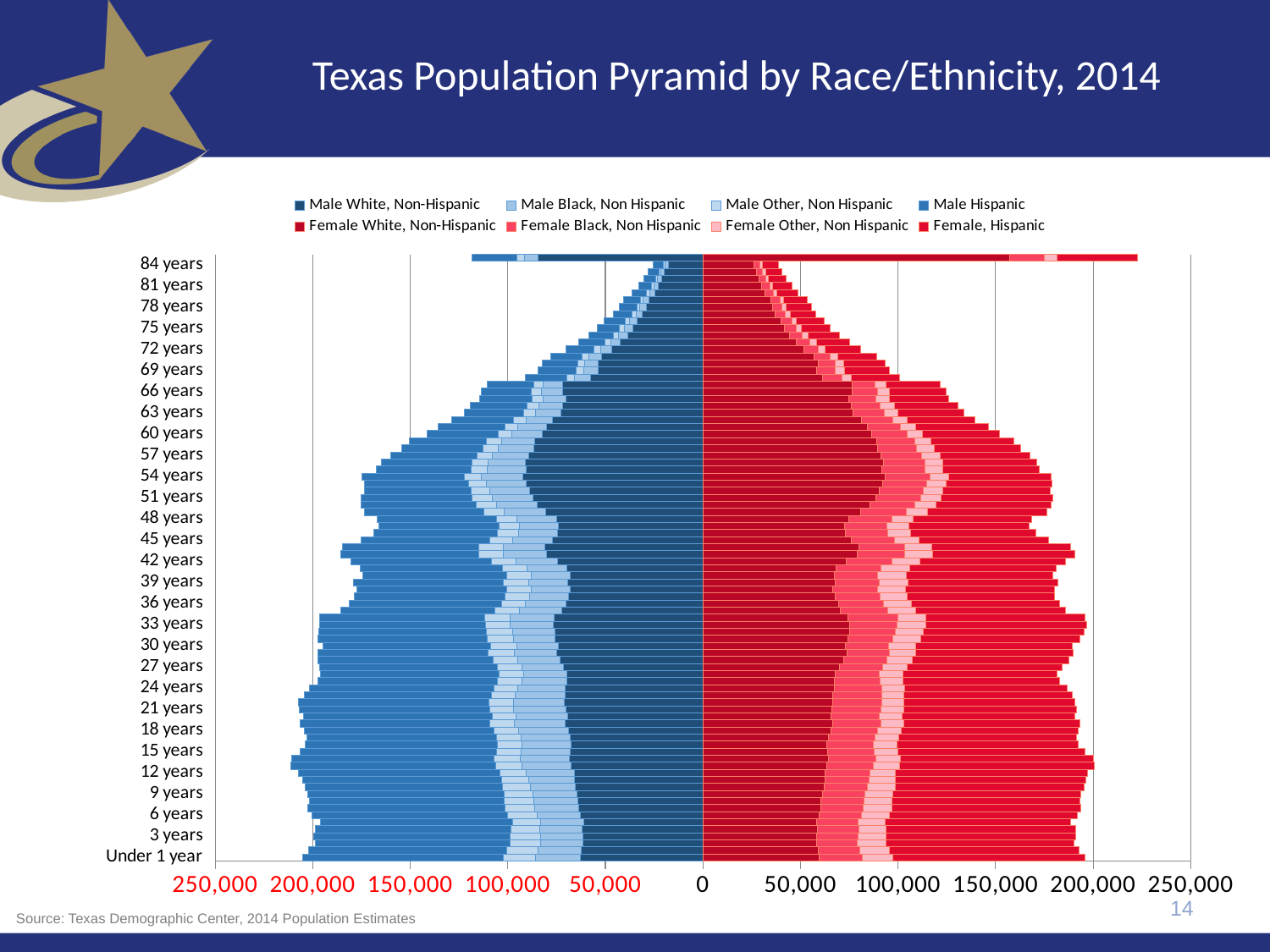
Is the total male bar for 72 years greater or less than 50,000? greater Is the total male bar for 81 years greater or less than 50,000? less What kind of chart is shown on the slide? Bar chart (population pyramid) Is the Male White, Non-Hispanic value for Under 1 year greater or less than 100,000? less Which is larger, the total male bar for 12 years or the total male bar for 60 years? 12 years What is the title of the chart? Texas Population Pyramid by Race/Ethnicity, 2014 Which side of the chart shows the female series, left or right? Right Which is larger, the total female bar for 84 years or the total male bar for 84 years? Female 84 years How many series does the legend list? 8